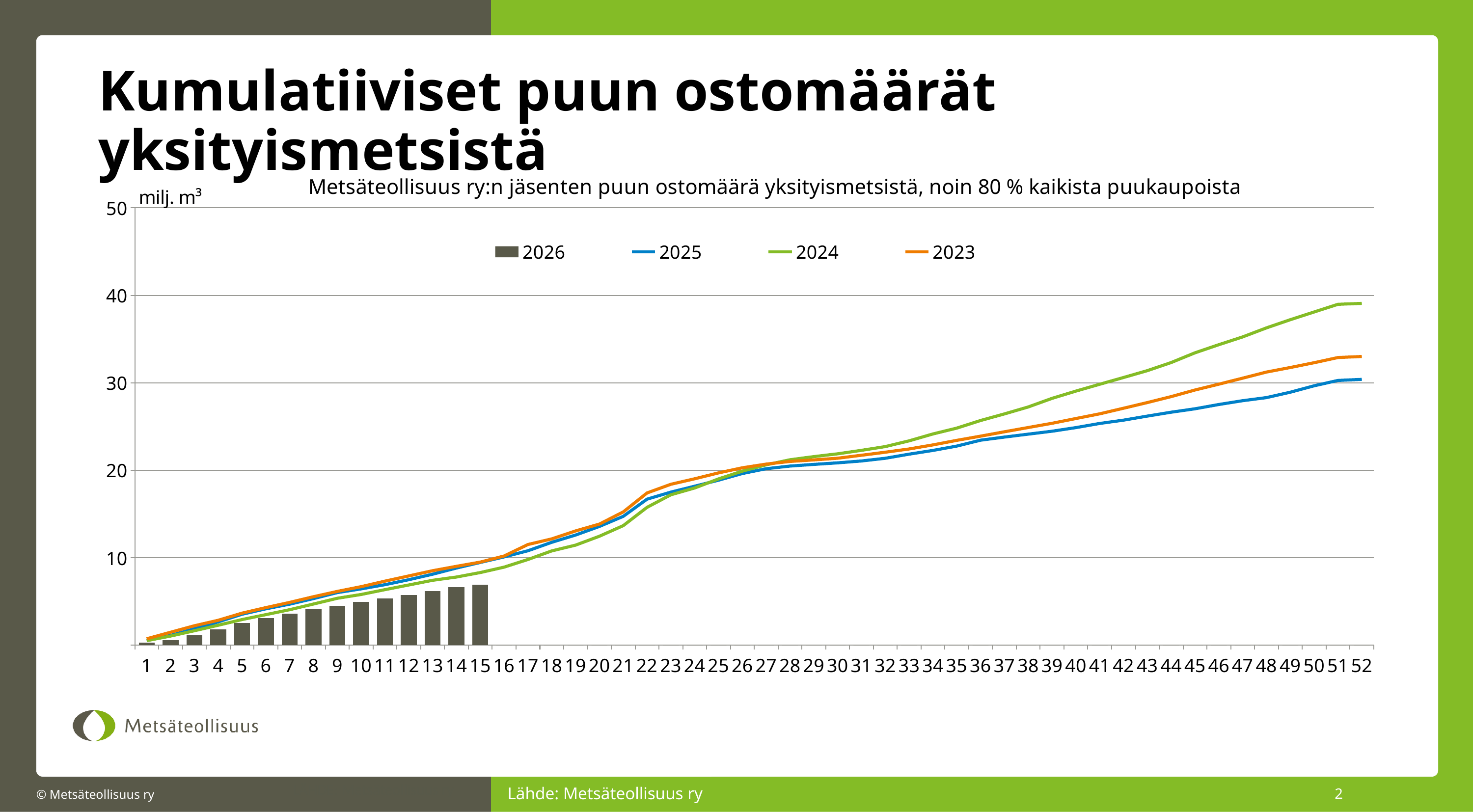
How many bars are plotted for the 2026 series? 15 Which series has the lowest value at week 52? 2025 Is the 2024 value at week 52 greater or less than 40? less How many week categories are shown on the x axis? 52 Is the 2023 value at week 52 greater or less than 30? greater Which series has the highest value at week 52? 2024 What kind of chart is this? Combined bar and line chart Do the line series rise or fall along the x axis from week 1 to week 52? rise Is the 2026 bar at week 15 greater or less than 10? less What unit is shown on the y axis? milj. m³ How many series does the legend list? 4 At week 52, which is larger: the 2024 value or the 2023 value? 2024